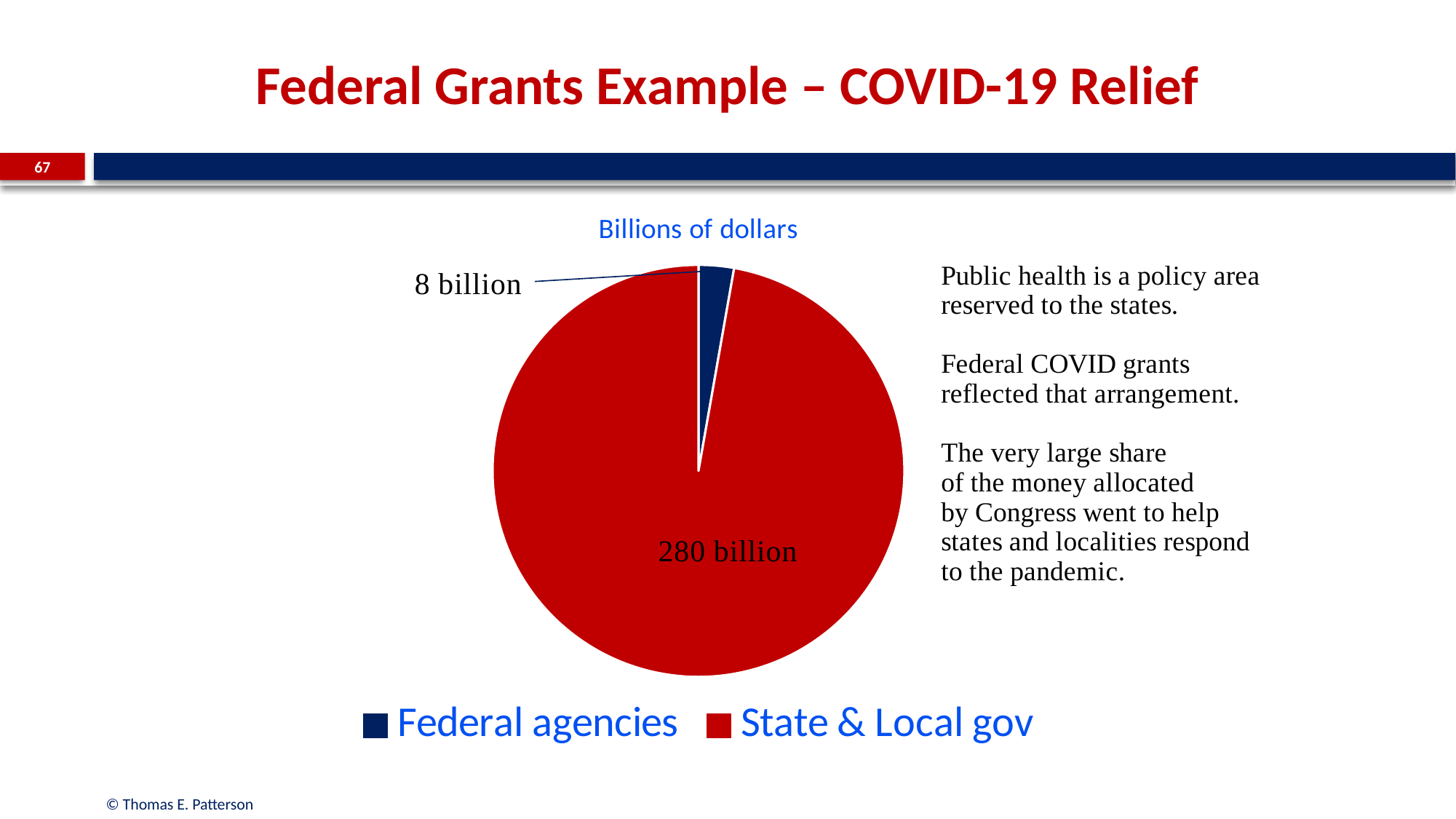
What is the total of the two slices? 288 billion What kind of chart is shown on the slide? pie chart What is the title of the chart? Billions of dollars What is the value for State & Local gov? 280 billion What is the difference between the State & Local gov value and the Federal agencies value? 272 billion Which category has the largest slice? State & Local gov Which category has the smallest slice? Federal agencies What is the value for Federal agencies? 8 billion How many entries does the legend list? 2 What colour is the State & Local gov slice? red How many slices does the pie chart have? 2 Which is larger, the value for Federal agencies or the value for State & Local gov? State & Local gov